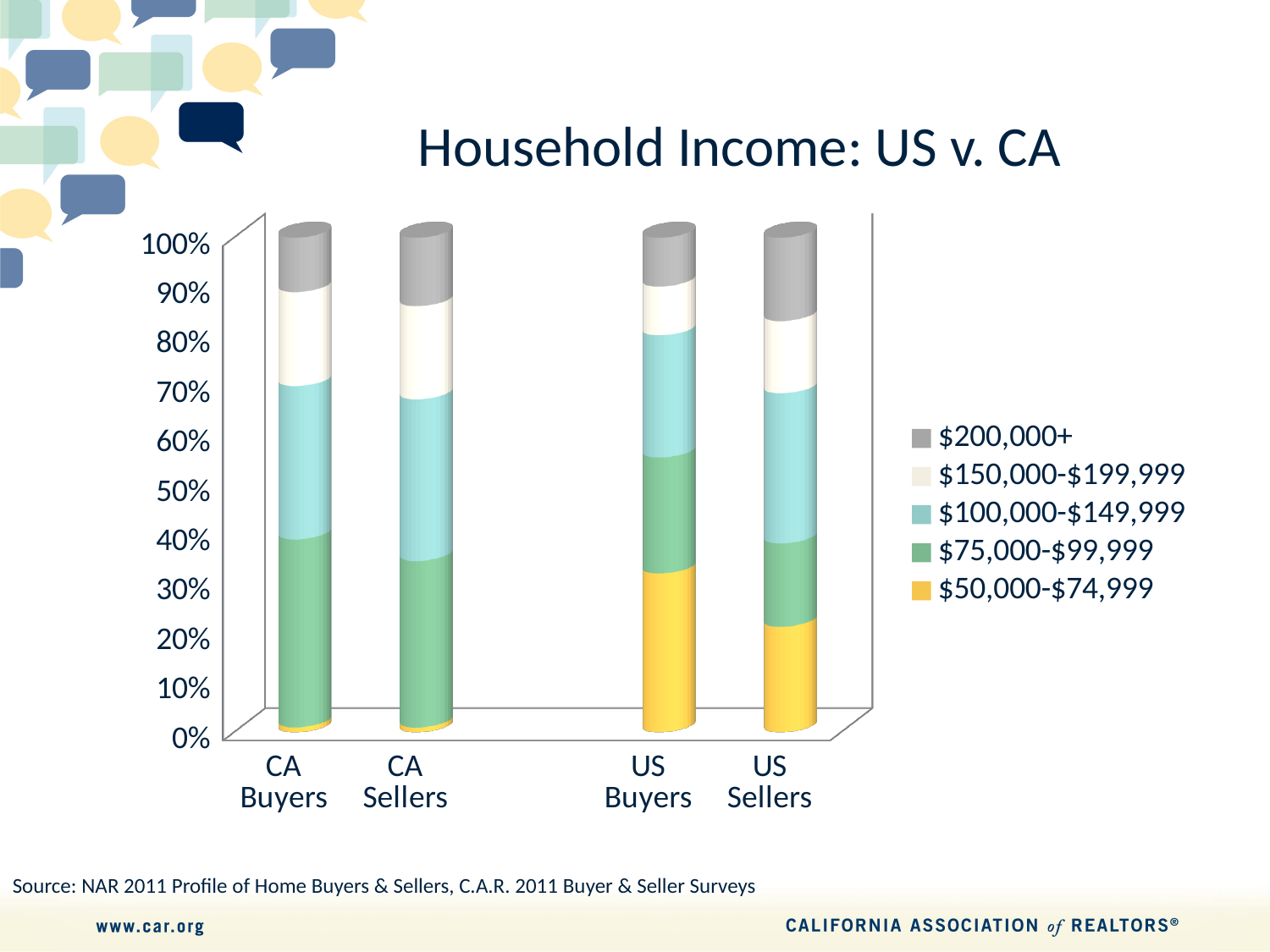
Is the $75,000-$99,999 share for CA Sellers greater or less than 20%? greater Is the $50,000-$74,999 share for US Buyers greater or less than 20%? greater Which category has the largest $50,000-$74,999 share? US Buyers Which has a larger $50,000-$74,999 share, US Buyers or CA Sellers? US Buyers Which has a larger $75,000-$99,999 share, CA Buyers or US Sellers? CA Buyers What is the total height of each stacked bar on the percentage axis? 100% What kind of chart is shown on the slide? Stacked bar chart Is the $50,000-$74,999 share for CA Buyers greater or less than 10%? less Which legend entry is shown in yellow? $50,000-$74,999 How many categories are shown along the x axis? 4 How many series does the legend list? 5 What is the title of the chart? Household Income: US v. CA